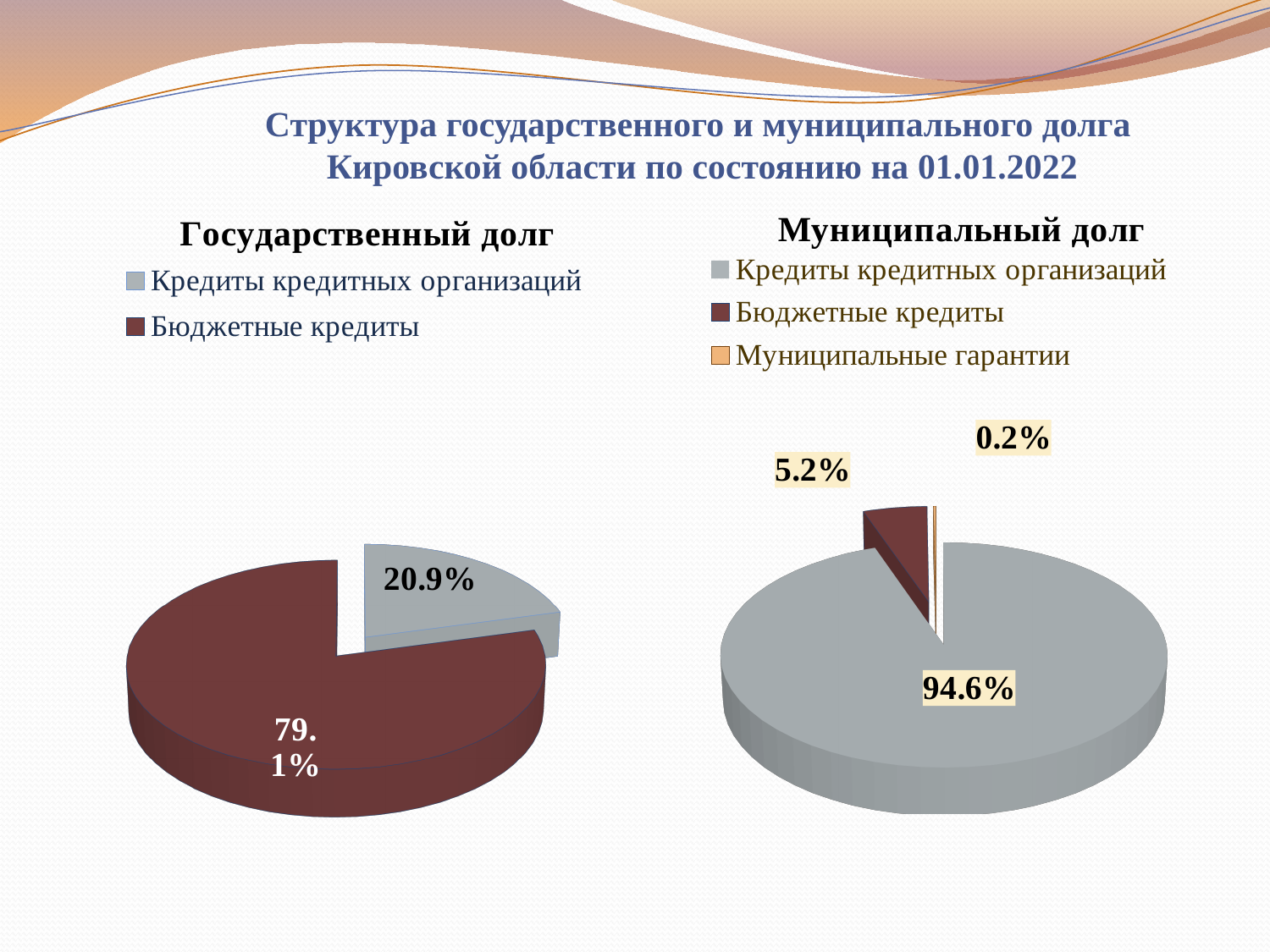
In the 'Муниципальный долг' chart, what share is labelled for 'Кредиты кредитных организаций'? 94.6% In the 'Государственный долг' chart, which category has the largest slice? Бюджетные кредиты In the 'Государственный долг' chart, what share is labelled for 'Бюджетные кредиты'? 79.1% In the 'Муниципальный долг' chart, which category has the largest slice? Кредиты кредитных организаций In the 'Муниципальный долг' chart, what share is labelled for 'Бюджетные кредиты'? 5.2% How many categories does the legend of the 'Муниципальный долг' chart list? 3 What type of chart is used for 'Государственный долг'? Pie chart In the 'Муниципальный долг' chart, which category has the smallest slice? Муниципальные гарантии In the 'Муниципальный долг' chart, what is the difference in percentage points between 'Бюджетные кредиты' and 'Муниципальные гарантии'? 5.0 In the 'Государственный долг' chart, what share is labelled for 'Кредиты кредитных организаций'? 20.9% In the 'Муниципальный долг' chart, what share is labelled for 'Муниципальные гарантии'? 0.2% In the 'Государственный долг' chart, what is the difference in percentage points between 'Бюджетные кредиты' and 'Кредиты кредитных организаций'? 58.2